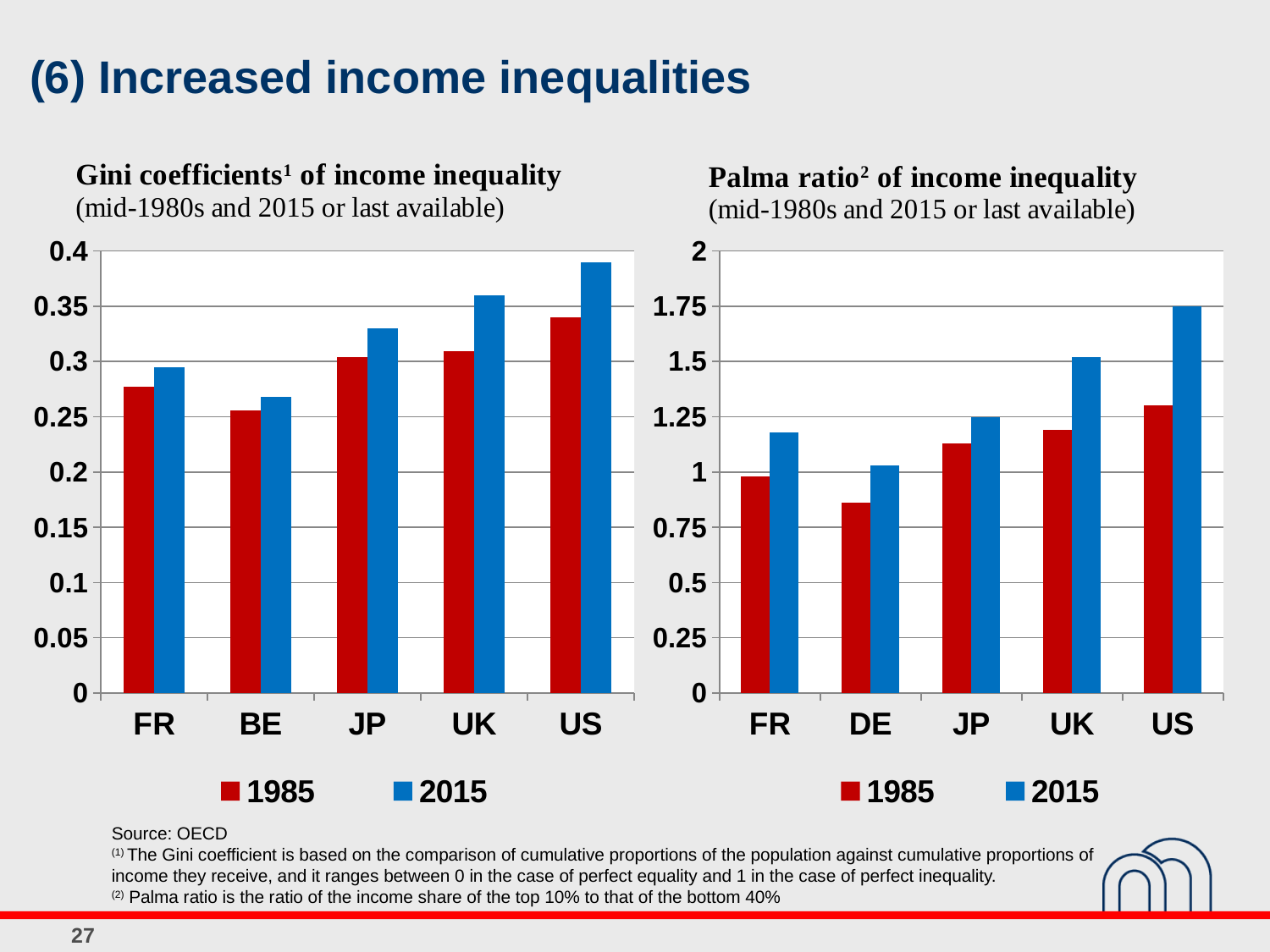
What kind of chart is the Palma ratio chart? Bar chart In the Gini coefficients chart, is the 1985 value for BE greater or less than 0.3? less In the Palma ratio chart, is the 2015 value for FR greater or less than 1? greater In the Gini coefficients chart, which country has the highest 2015 value? US How many countries are shown on the x axis of the Gini coefficients chart? 5 In the Gini coefficients chart, which country has the lowest 2015 value? BE In the Palma ratio chart, which country has the lowest 2015 value? DE How many series does the legend of the Palma ratio chart list? 2 In the Gini coefficients chart, is the 2015 value for US greater or less than 0.35? greater In the Palma ratio chart, which country has the highest 2015 value? US In the Gini coefficients chart, which is larger: the 2015 value for UK or the 2015 value for JP? UK